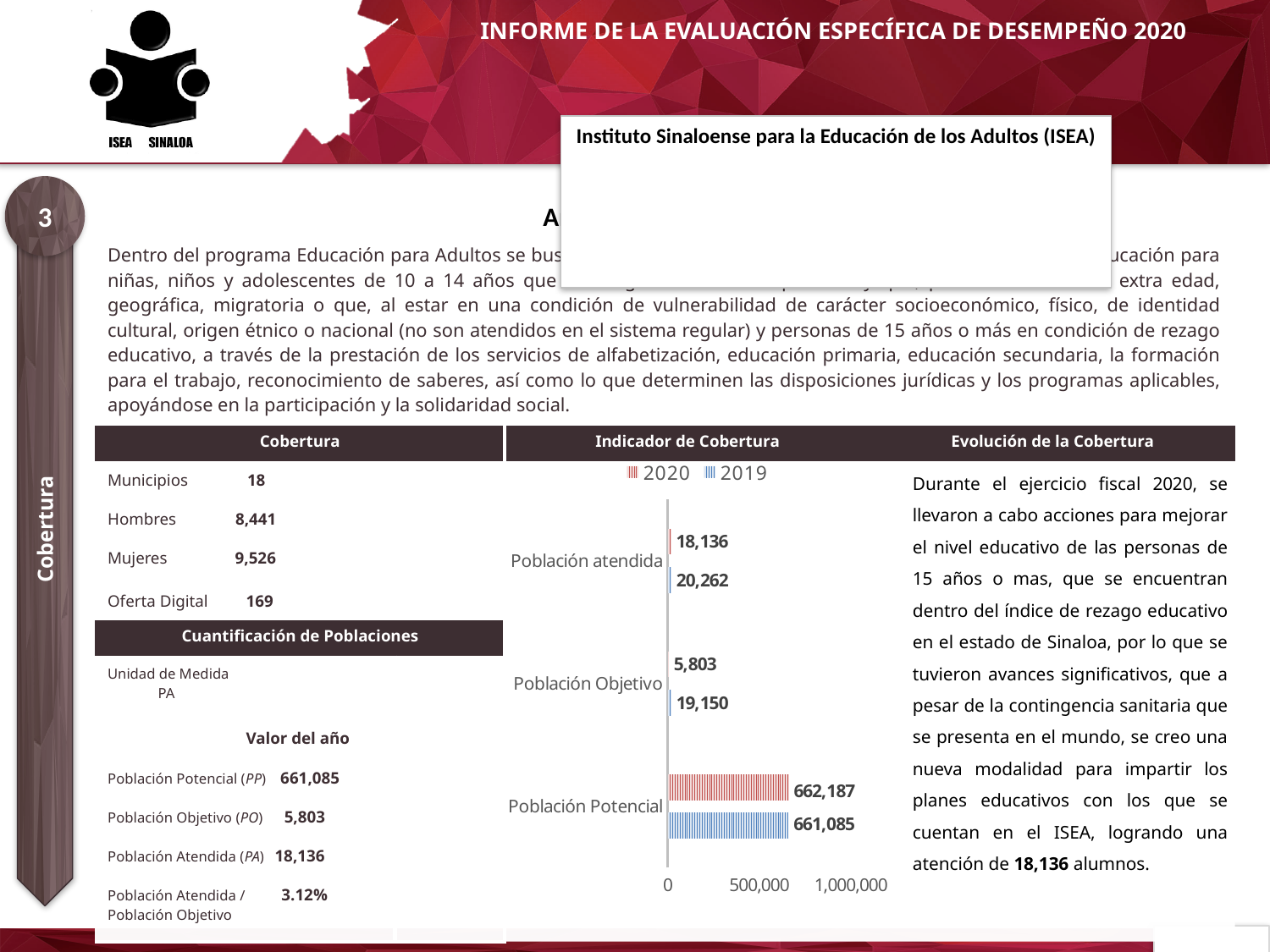
In the "Indicador de Cobertura" chart, what is the 2020 value for Población atendida? 18,136 In the "Indicador de Cobertura" chart, what is the difference between the 2019 and 2020 values for Población Objetivo? 13,347 In the "Indicador de Cobertura" chart, which category has the lowest 2020 value? Población Objetivo In the "Indicador de Cobertura" chart, what is the 2020 value for Población Potencial? 662,187 How many series does the legend of the "Indicador de Cobertura" chart list? 2 How many categories are plotted in the "Indicador de Cobertura" chart? 3 In the "Indicador de Cobertura" chart, which category has the highest 2020 value? Población Potencial In the "Indicador de Cobertura" chart, which is larger for Población atendida: the 2020 value or the 2019 value? 2019 In the "Indicador de Cobertura" chart, what is the 2019 value for Población Potencial? 661,085 In the "Indicador de Cobertura" chart, which series is shown in red? 2020 In the "Indicador de Cobertura" chart, what is the 2019 value for Población Objetivo? 19,150 What type of chart is shown under "Indicador de Cobertura"? bar chart